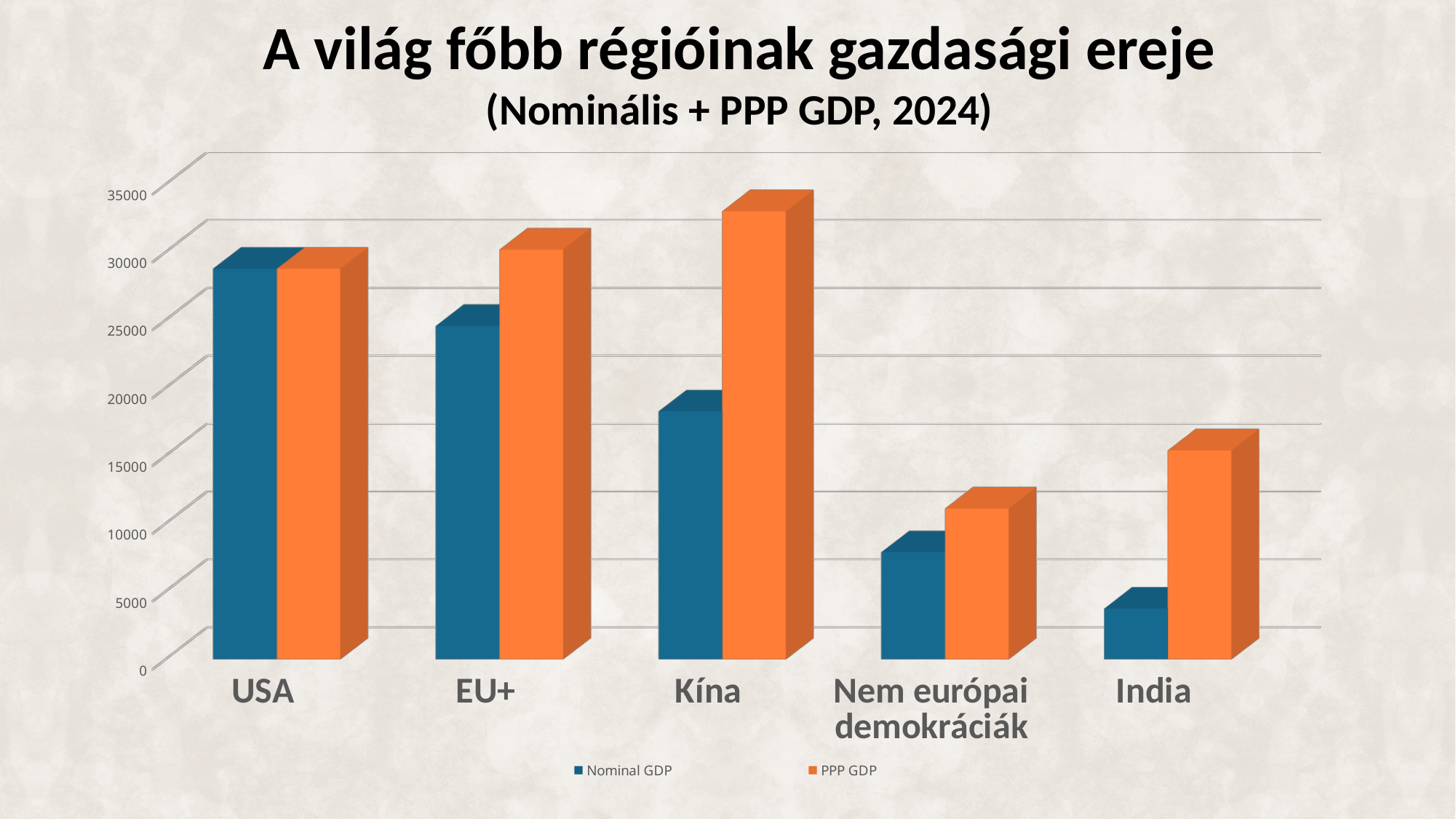
What kind of chart is shown on the slide? bar chart Which region has the lowest PPP GDP bar? Nem európai demokráciák Which region has the lowest Nominal GDP bar? India How many series does the legend list? 2 Which region has the highest Nominal GDP bar? USA What are the two series named in the legend? Nominal GDP and PPP GDP Is the Nominal GDP value for Kína greater or less than 20000? less How many regions (categories) are shown on the x axis? 5 Is the Nominal GDP value for India greater or less than 5000? less For EU+, which is larger: Nominal GDP or PPP GDP? PPP GDP Which region has the highest PPP GDP bar? Kína